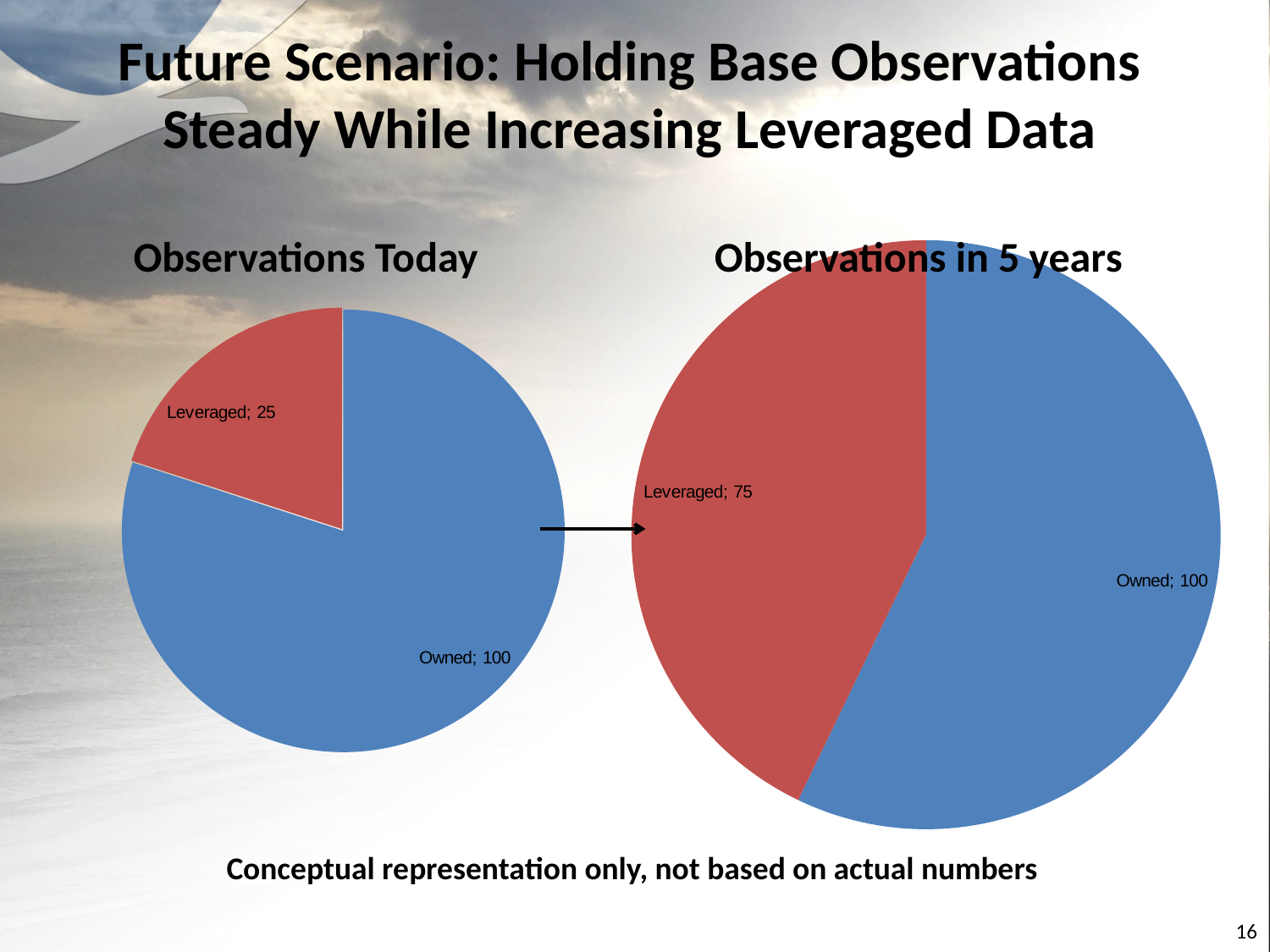
How many slices does the 'Observations Today' pie chart have? 2 In the 'Observations Today' pie chart, which slice is the largest? Owned In the 'Observations Today' pie chart, what is the difference between the Owned and Leveraged values? 75 In the 'Observations in 5 years' pie chart, what is the difference between the Owned and Leveraged values? 25 In the 'Observations in 5 years' pie chart, which slice is the smallest? Leveraged In the 'Observations in 5 years' pie chart, what is the value for Leveraged? 75 What type of chart is used for 'Observations in 5 years'? Pie chart In the 'Observations Today' pie chart, what is the value for Leveraged? 25 In the 'Observations Today' pie chart, what share of the total does the Leveraged slice represent? 20% Is the Leveraged value larger in the 'Observations Today' chart or the 'Observations in 5 years' chart? Observations in 5 years In the 'Observations in 5 years' pie chart, what is the value for Owned? 100 In the 'Observations Today' pie chart, what is the value for Owned? 100